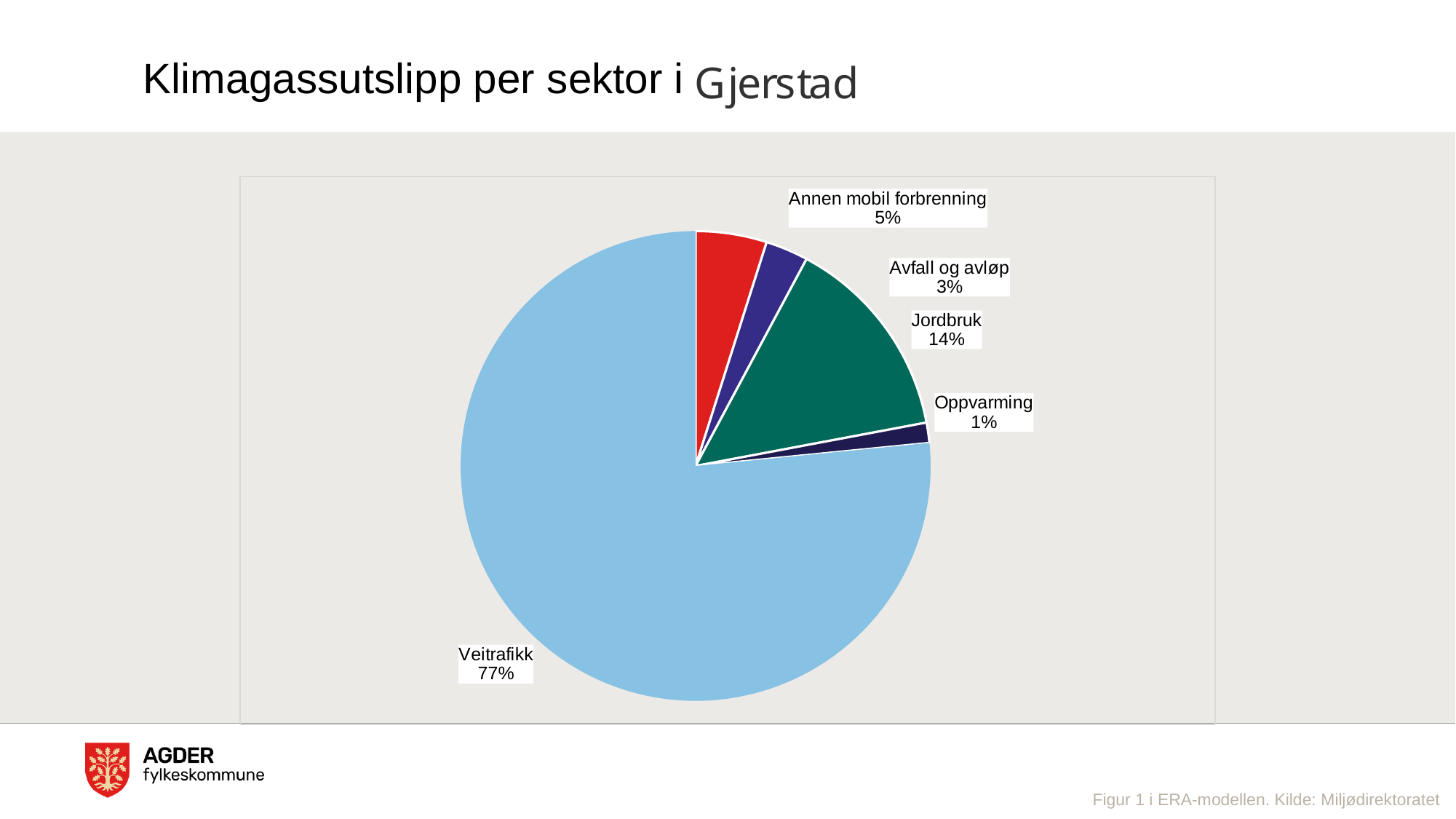
What is the value shown for Oppvarming? 1% What share of emissions does Jordbruk account for? 14% What share of emissions does Veitrafikk account for? 77% What kind of chart is shown on the slide? pie chart Which sector has the largest share of emissions? Veitrafikk How many sectors are shown in the pie chart? 5 What is the value shown for Avfall og avløp? 3% What is the difference in percentage points between Veitrafikk and Jordbruk? 63 What is the title of the slide containing the chart? Klimagassutslipp per sektor i Gjerstad What is the value shown for Annen mobil forbrenning? 5% Which is larger, Annen mobil forbrenning or Avfall og avløp? Annen mobil forbrenning Which sector has the smallest share of emissions? Oppvarming